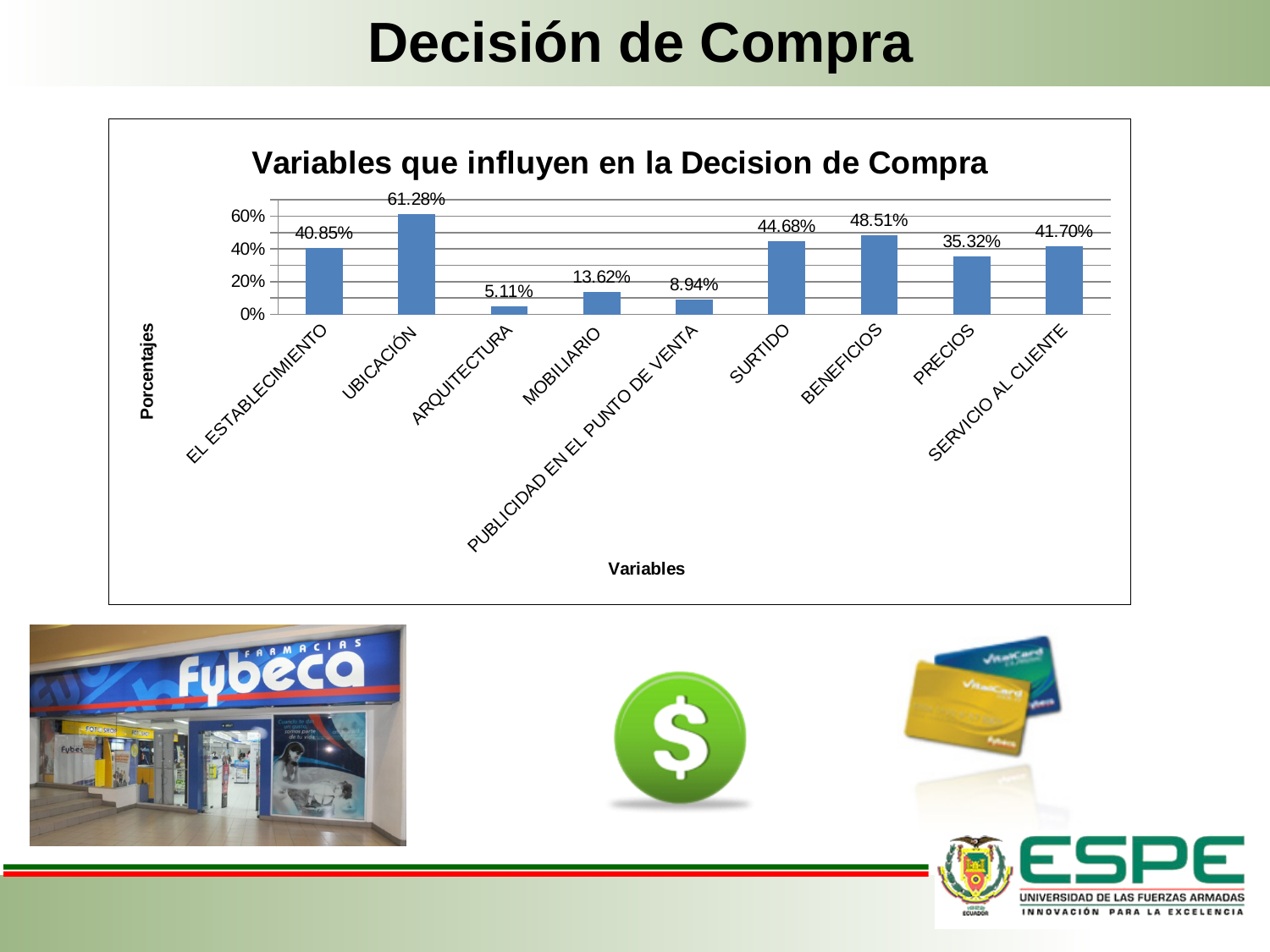
What kind of chart is shown? bar chart Which category has the lowest value? ARQUITECTURA Which is larger, the value for SURTIDO or the value for PRECIOS? SURTIDO Is the value for MOBILIARIO greater or less than 20%? less What is the value for UBICACIÓN? 61.28% What is the label of the y axis? Porcentajes What is the title of the chart? Variables que influyen en la Decision de Compra How many categories are shown on the x axis? 9 What is the value for PUBLICIDAD EN EL PUNTO DE VENTA? 8.94% What is the difference between the values for UBICACIÓN and EL ESTABLECIMIENTO? 20.43% Which category has the highest value? UBICACIÓN What is the value for BENEFICIOS? 48.51%